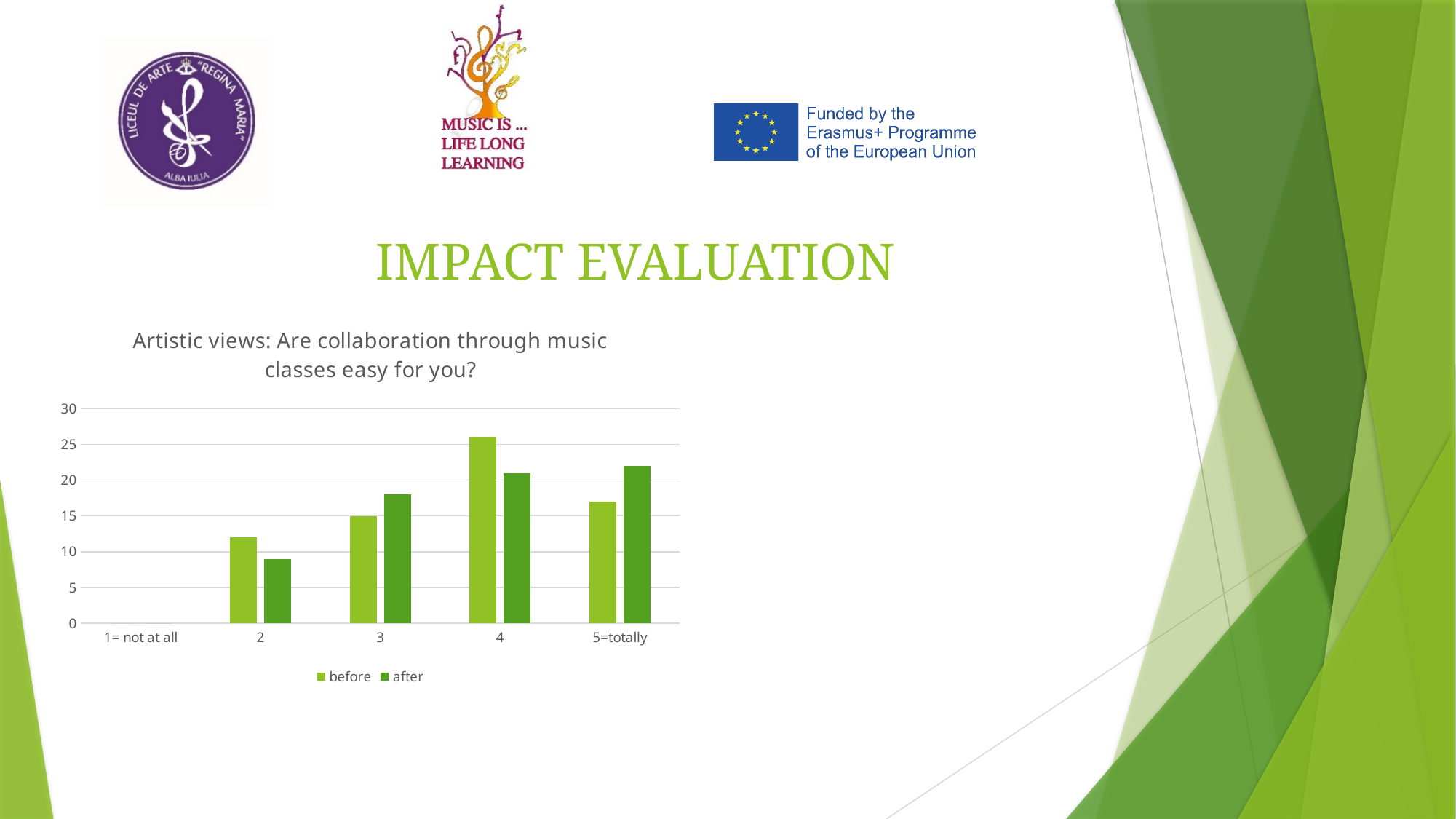
What kind of chart is shown on the slide? bar chart How many categories are shown on the x axis of the chart? 5 How many series does the chart's legend list? 2 Which category has the highest 'before' value? 4 What is the title of the chart? Artistic views: Are collaboration through music classes easy for you? Is the 'after' value for category 2 greater or less than 10? less For category 4, which series has the larger value, 'before' or 'after'? before Is the 'after' value for '5=totally' greater or less than 20? greater Is the 'before' value for '5=totally' greater or less than 20? less Which category has the lowest 'after' value? 1= not at all For '5=totally', which series has the larger value, 'before' or 'after'? after